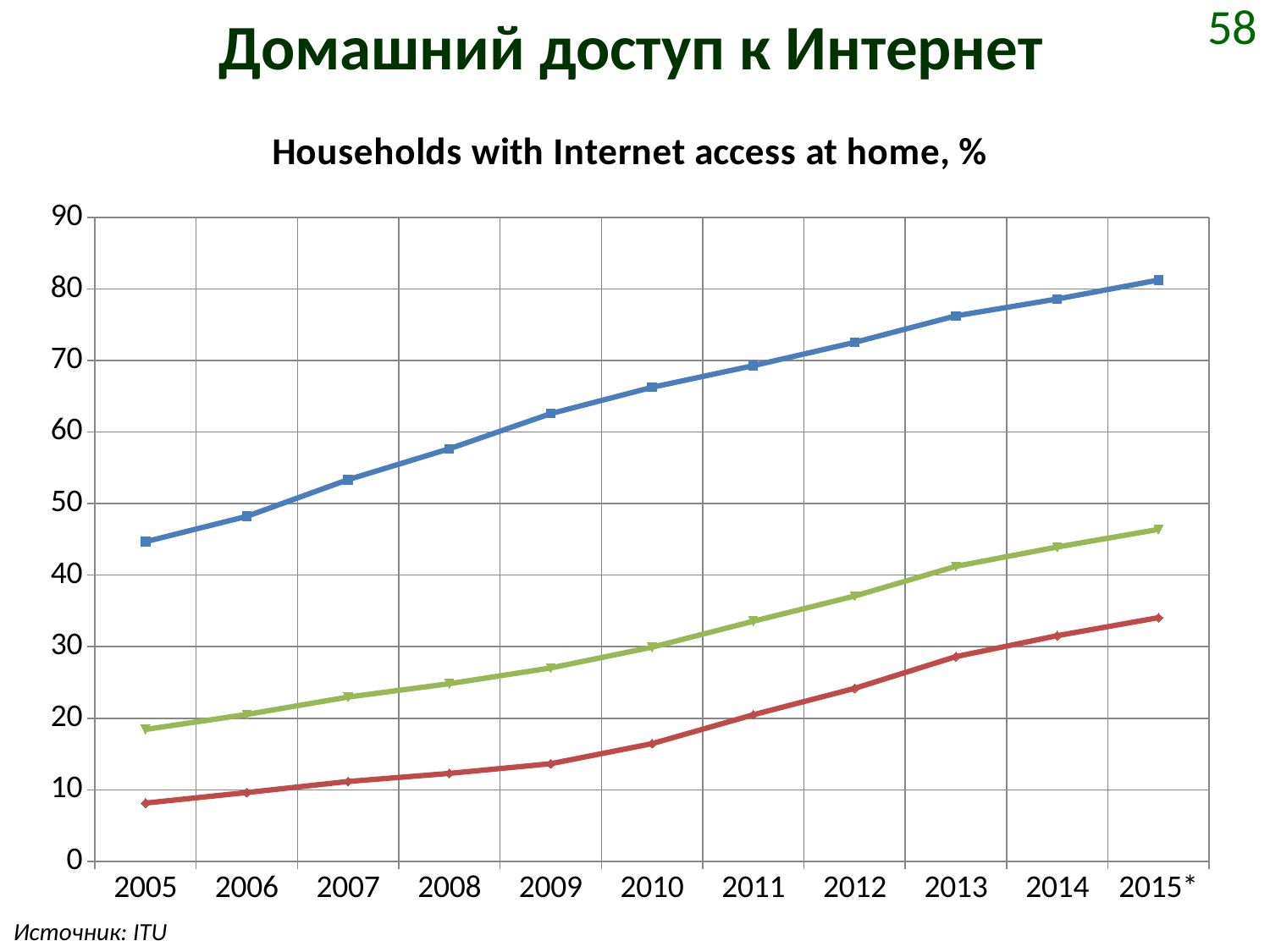
Is the value of the blue line in 2005 greater or less than 40? greater What is the title of the chart? Households with Internet access at home, % Do the values of the blue line rise or fall from 2005 to 2015*? rise In 2012, which line has the larger value: the green line or the red line? green Which line has the highest values across all years: blue, green or red? blue Is the value of the red line in 2005 greater or less than 10? less What kind of chart is shown on the slide? line chart Is the value of the blue line in 2010 greater or less than 60? greater Which line has the lowest values across all years: blue, green or red? red How many years are shown on the x axis of the chart? 11 How many lines are plotted on the chart? 3